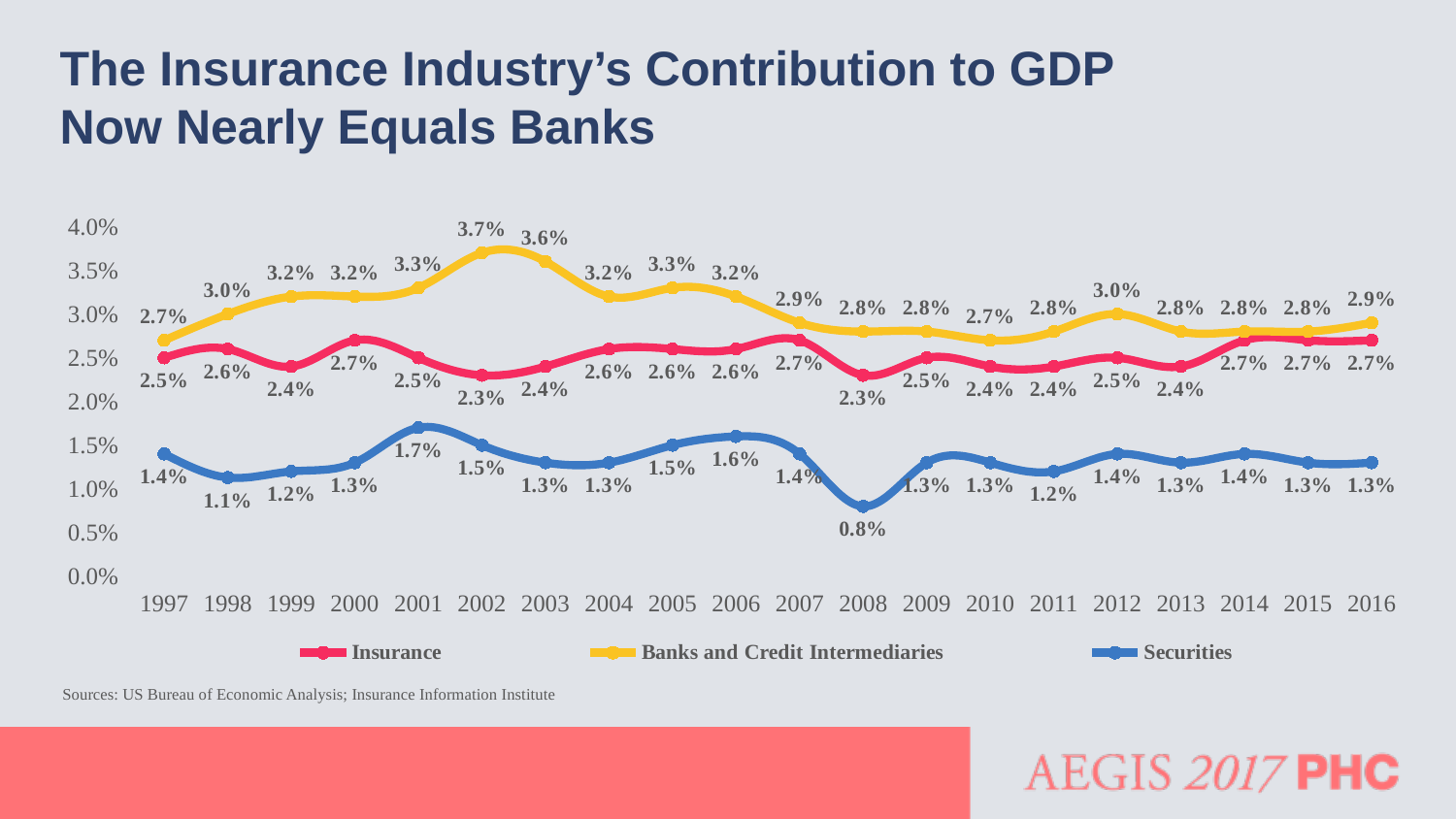
What was the Insurance value in 2016? 2.7% In which year did the Banks and Credit Intermediaries series reach its highest value? 2002 What is the difference between the Banks and Credit Intermediaries value and the Insurance value in 2016? 0.2% What kind of chart is shown on the slide? Line chart Did the Banks and Credit Intermediaries value rise or fall from 2002 to 2004? Fall In which year did the Securities series reach its lowest value? 2008 What is the difference between the Securities value in 2001 and in 2008? 0.9% What was the Securities value in 2001? 1.7% How many years are shown on the x axis? 20 What was the Banks and Credit Intermediaries value in 2002? 3.7% Which series had the higher value in 2008, Insurance or Securities? Insurance How many series does the legend list? 3